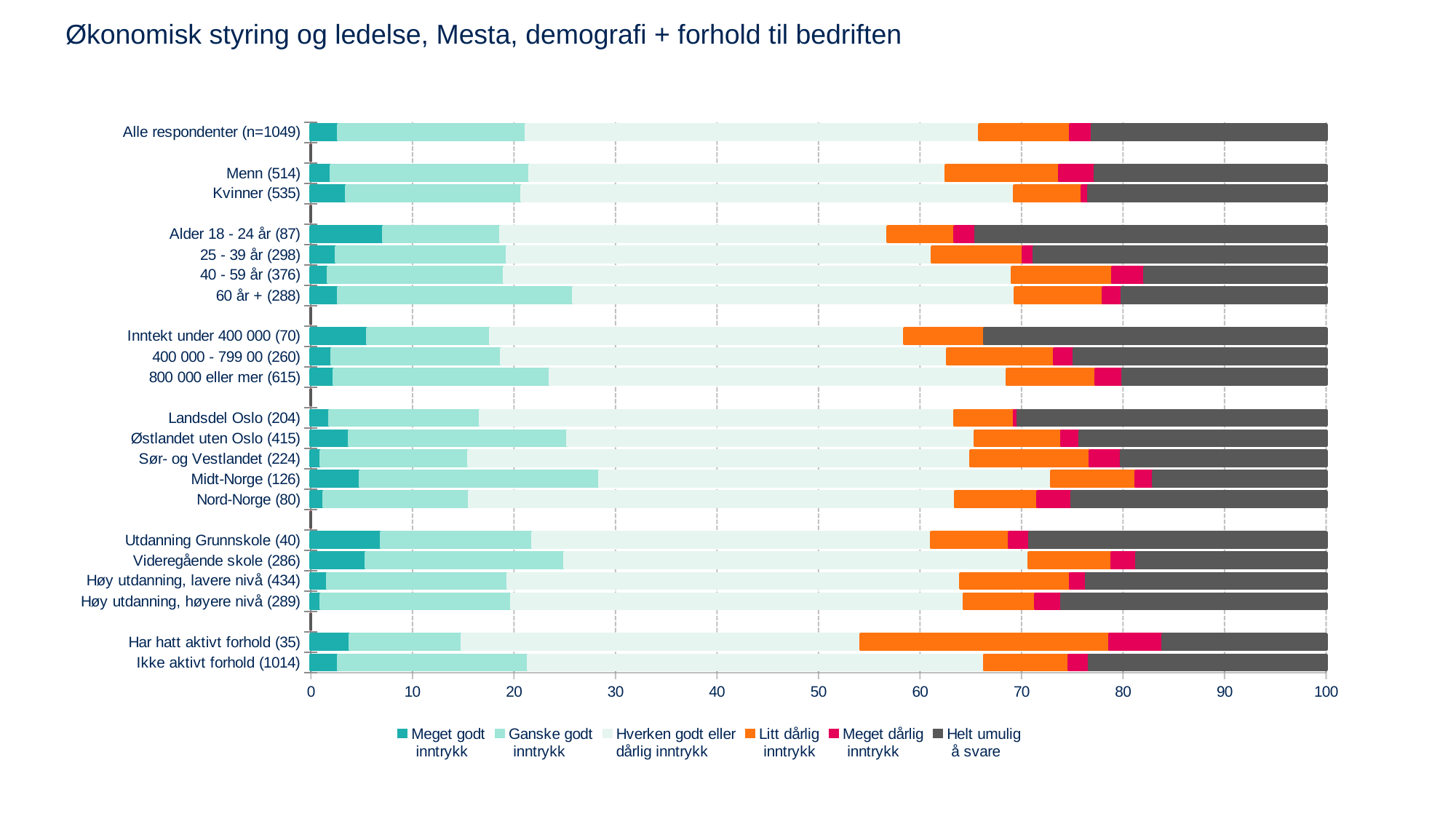
Which has the larger 'Helt umulig å svare' segment: 'Alder 18 - 24 år (87)' or 'Har hatt aktivt forhold (35)'? Alder 18 - 24 år (87) Which has the larger 'Litt dårlig inntrykk' segment: 'Har hatt aktivt forhold (35)' or 'Inntekt under 400 000 (70)'? Har hatt aktivt forhold (35) Is the 'Helt umulig å svare' segment for 'Alder 18 - 24 år (87)' greater or less than 30? greater How many series does the legend list? 6 What kind of chart is shown on the slide? Stacked bar chart Which category has the largest 'Litt dårlig inntrykk' segment? Har hatt aktivt forhold (35) Which legend entry is shown in dark grey at the right end of each bar? Helt umulig å svare What is the title of the chart? Økonomisk styring og ledelse, Mesta, demografi + forhold til bedriften How many respondent groups (categories) are plotted on the chart? 21 Is the combined share of 'Meget godt inntrykk' and 'Ganske godt inntrykk' for 'Midt-Norge (126)' greater or less than 20? greater Is the 'Meget godt inntrykk' segment for 'Alder 18 - 24 år (87)' greater or less than 10? less